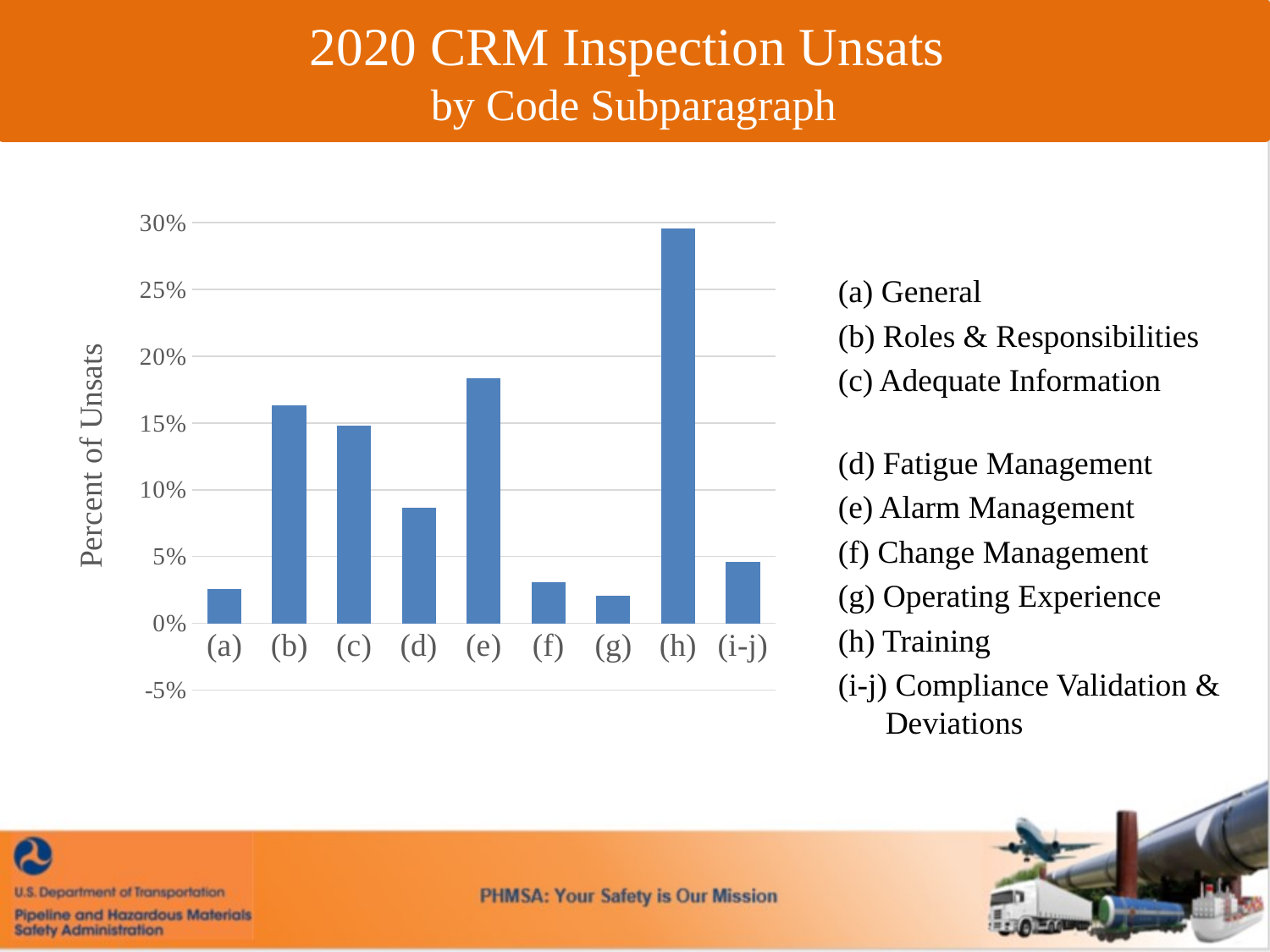
Is the value for (a) greater or less than 5%? less According to the key on the slide, what does subparagraph (h) refer to? Training Is the value for (h) greater or less than 25%? greater Which is larger, the value for (e) or the value for (b)? (e) Is the value for (b) greater or less than 15%? greater How many code subparagraph categories are plotted on the x axis? 9 Which code subparagraph has the highest percent of unsats? (h) What is the label on the vertical axis of the chart? Percent of Unsats Which is larger, the value for (d) or the value for (i-j)? (d) What kind of chart is shown on the slide? bar chart